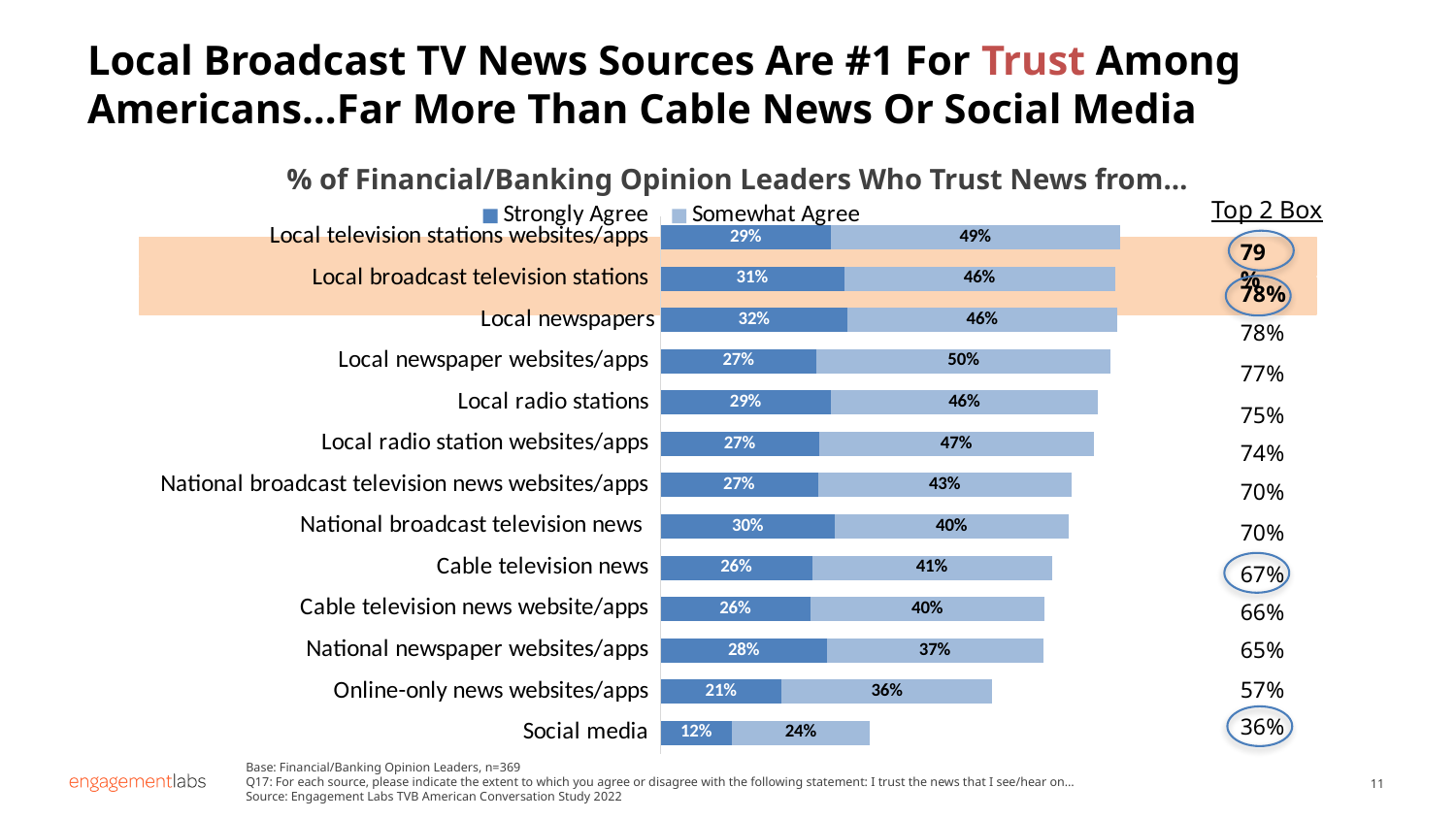
What is the difference between the Strongly Agree values for Local broadcast television stations and Cable television news? 5 percentage points What kind of chart is shown on the slide? Stacked bar chart How many series does the legend list? 2 What are the two series named in the legend? Strongly Agree and Somewhat Agree What is the total of the stacked bar for Social media? 36% What is the Strongly Agree value for Social media? 12% What is the Strongly Agree value for Online-only news websites/apps? 21% Which news source has the highest Strongly Agree value? Local newspapers How many news sources are shown in the chart? 13 Which news source has the lowest Somewhat Agree value? Social media What is the Somewhat Agree value for Local newspaper websites/apps? 50% Which has a larger Somewhat Agree value: Local radio stations or National broadcast television news? Local radio stations